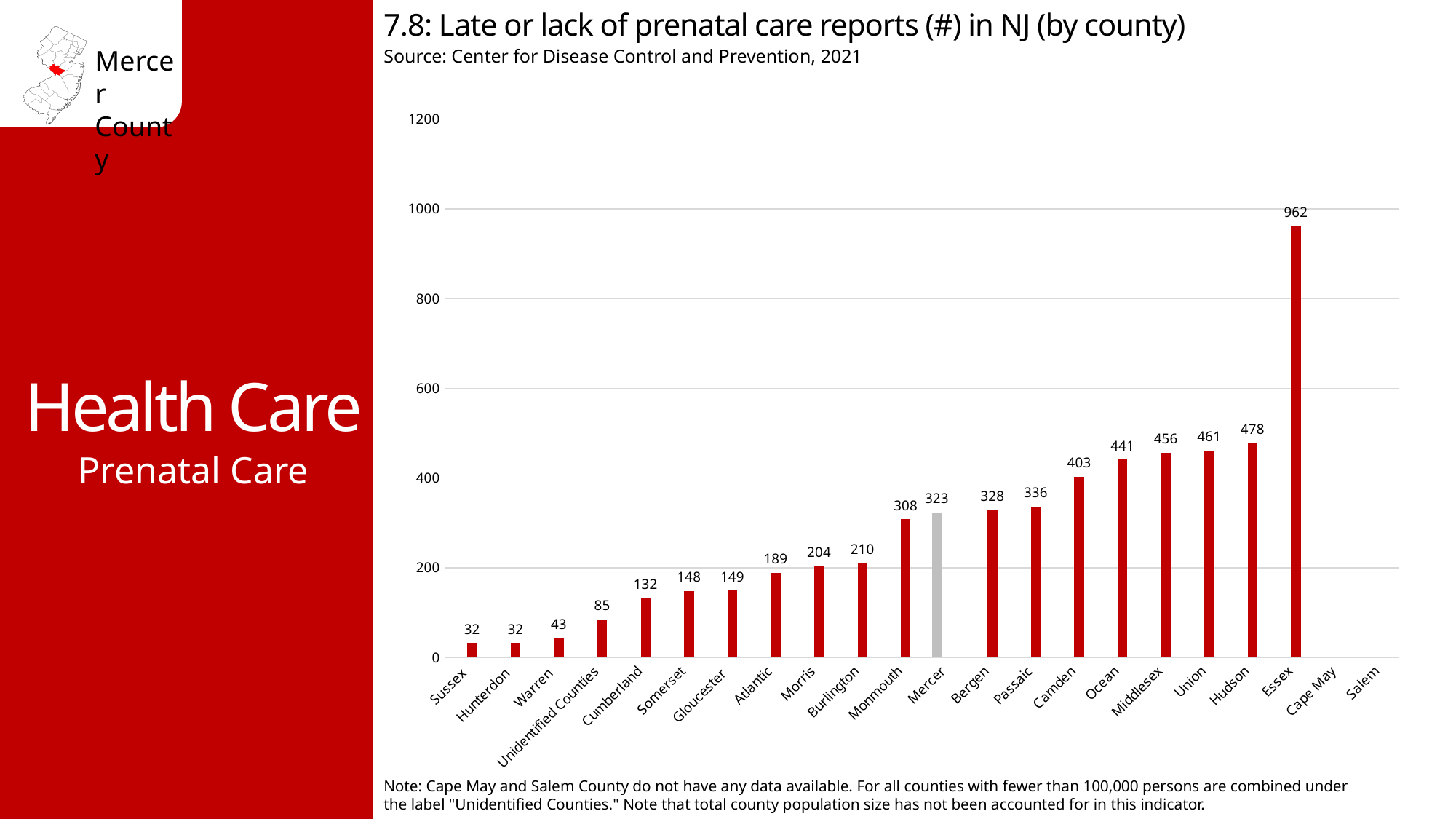
Which two counties on the x axis have no bar shown? Cape May and Salem What kind of chart is shown on the slide? Bar chart How many county categories are listed on the x axis? 22 Is the value for Ocean greater or less than 400? greater What is the value shown for Essex County? 962 Which has a larger value, Camden or Bergen? Camden What is the value shown for Unidentified Counties? 85 What is the difference between the values for Mercer and Monmouth? 15 Do the values generally rise or fall from Sussex to Essex along the x axis? Rise Which county has the highest number of late or lack of prenatal care reports? Essex What is the number of late or lack of prenatal care reports for Mercer County? 323 What is the difference between the values for Essex and Hudson? 484